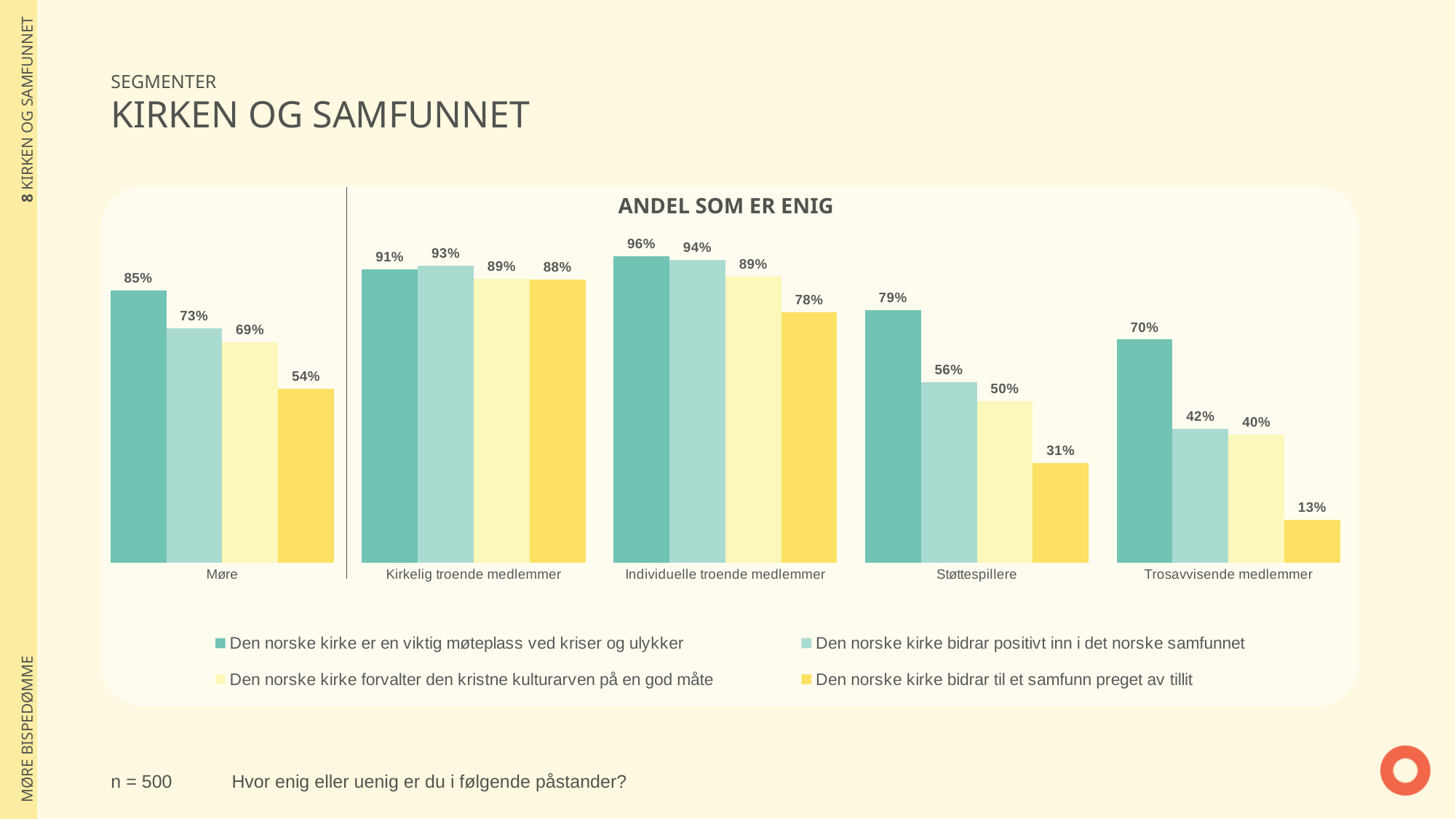
What is the value for 'Den norske kirke er en viktig møteplass ved kriser og ulykker' in the Møre category? 85% How many categories are shown on the x axis of the chart? 5 What is the value for 'Den norske kirke bidrar til et samfunn preget av tillit' among Trosavvisende medlemmer? 13% Which category has the lowest value for 'Den norske kirke bidrar til et samfunn preget av tillit'? Trosavvisende medlemmer How many series does the legend list? 4 What kind of chart is shown on the slide? Bar chart Which category has the highest value for 'Den norske kirke er en viktig møteplass ved kriser og ulykker'? Individuelle troende medlemmer What is the difference between the 'Den norske kirke er en viktig møteplass ved kriser og ulykker' value and the 'Den norske kirke bidrar til et samfunn preget av tillit' value for Støttespillere? 48 percentage points Which is larger for Kirkelig troende medlemmer: 'Den norske kirke er en viktig møteplass ved kriser og ulykker' or 'Den norske kirke bidrar positivt inn i det norske samfunnet'? Den norske kirke bidrar positivt inn i det norske samfunnet What is the title of the chart? ANDEL SOM ER ENIG What is the value for 'Den norske kirke bidrar positivt inn i det norske samfunnet' among Støttespillere? 56% What is the value for 'Den norske kirke forvalter den kristne kulturarven på en god måte' among Individuelle troende medlemmer? 89%